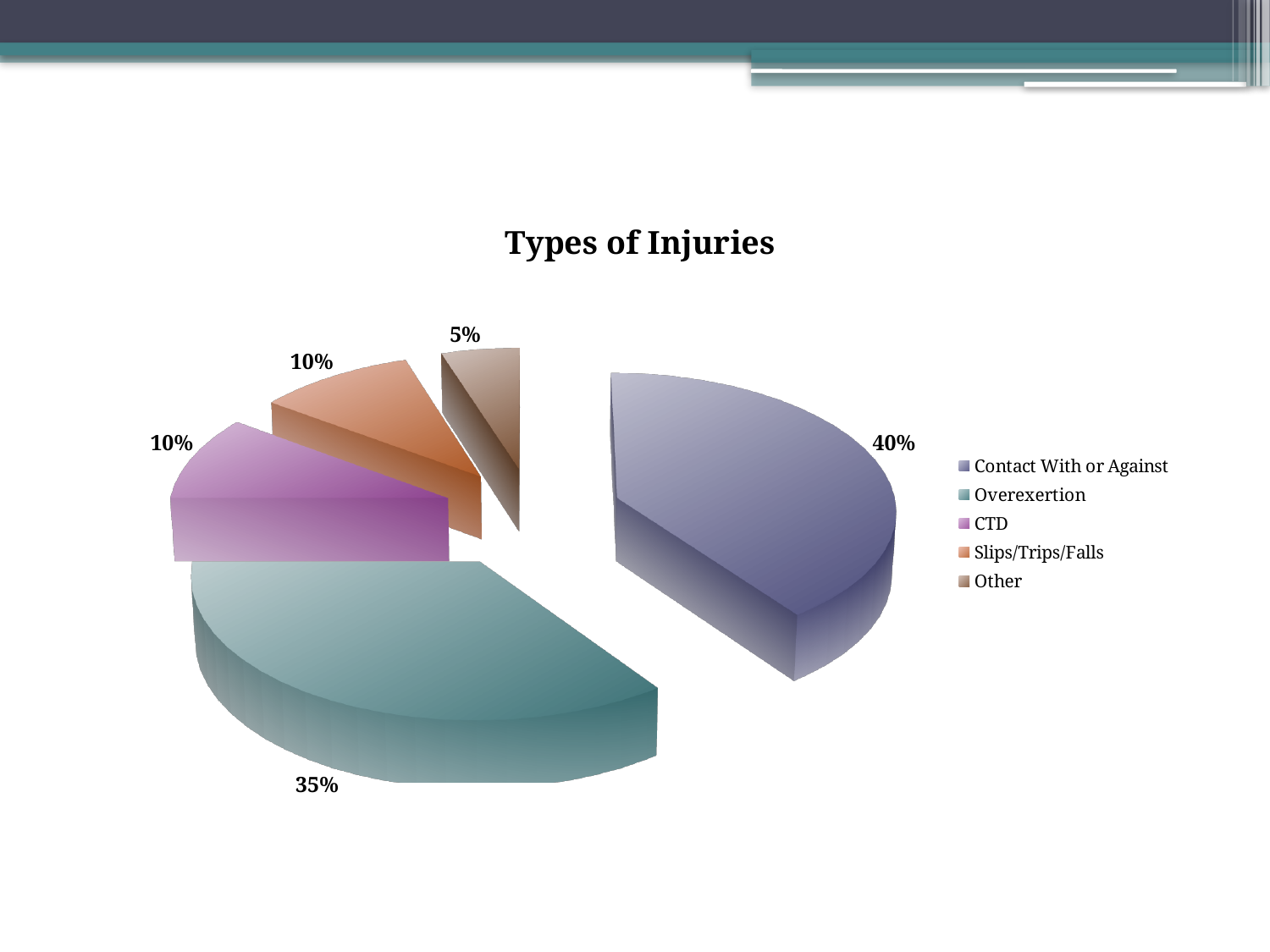
What is the difference in percentage points between Contact With or Against and Overexertion? 5 Which legend entry is listed last? Other What share of injuries is Other? 5% What share of injuries is Overexertion? 35% What share of injuries is Contact With or Against? 40% Which type of injury has the smallest share? Other What type of chart is shown on the slide? pie chart Which is larger, the share for CTD or the share for Other? CTD What is the title of the chart? Types of Injuries Which type of injury has the largest share? Contact With or Against What share of injuries is Slips/Trips/Falls? 10% How many categories does the pie chart have? 5